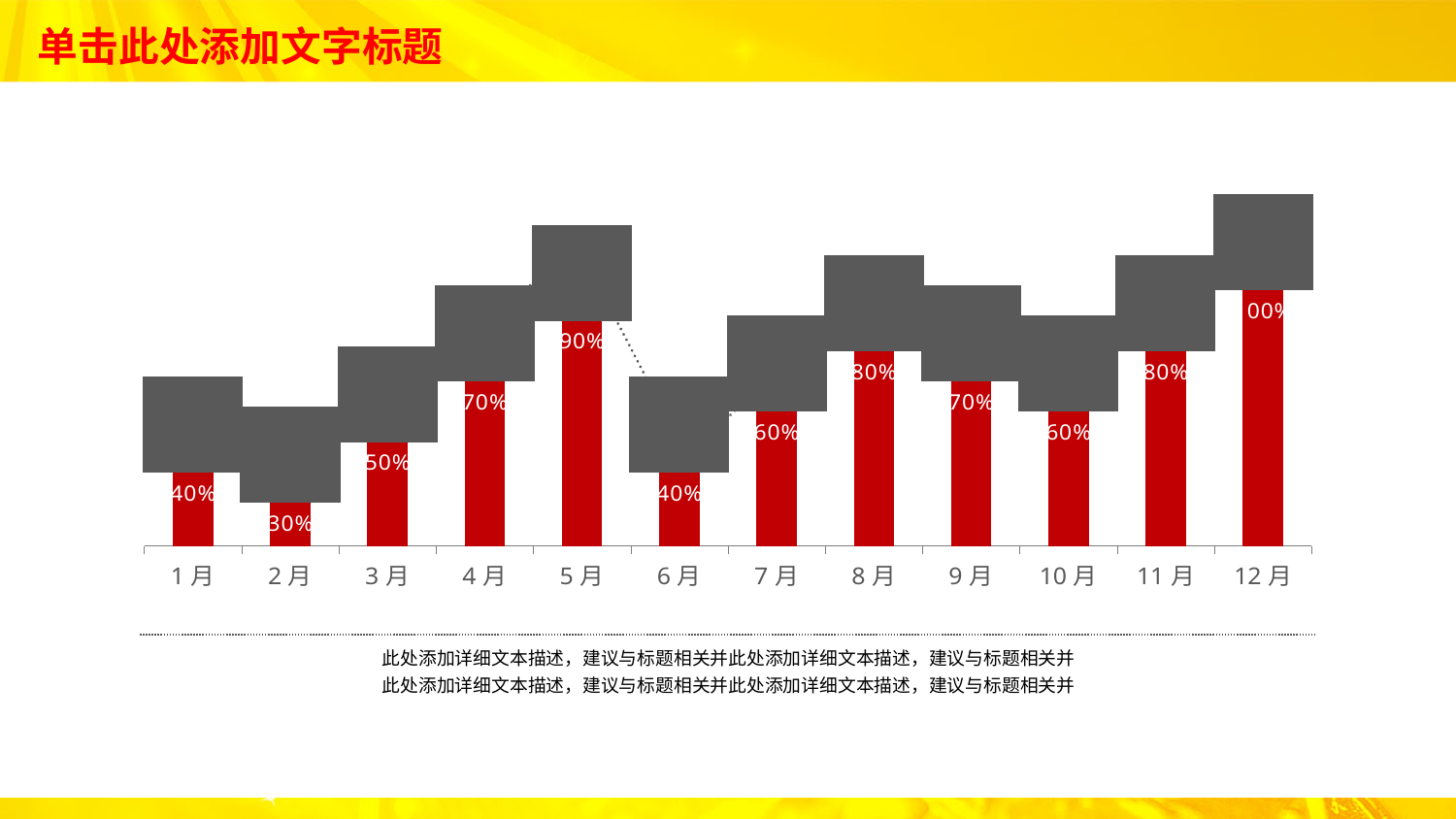
What is the difference between the values for 5月 and 6月? 50% What is the value for 10月? 60% Which is larger, the value for 7月 or the value for 9月? 9月 What is the value for 8月? 80% How many months are shown on the x axis? 12 Which month has the lowest value? 2月 What kind of chart is this? Bar chart Do the values rise or fall from 1月 to 5月? Rise What is the value for 5月? 90% What is the difference between the values for 4月 and 3月? 20% Which month has the tallest bar? 12月 What is the value for 2月? 30%